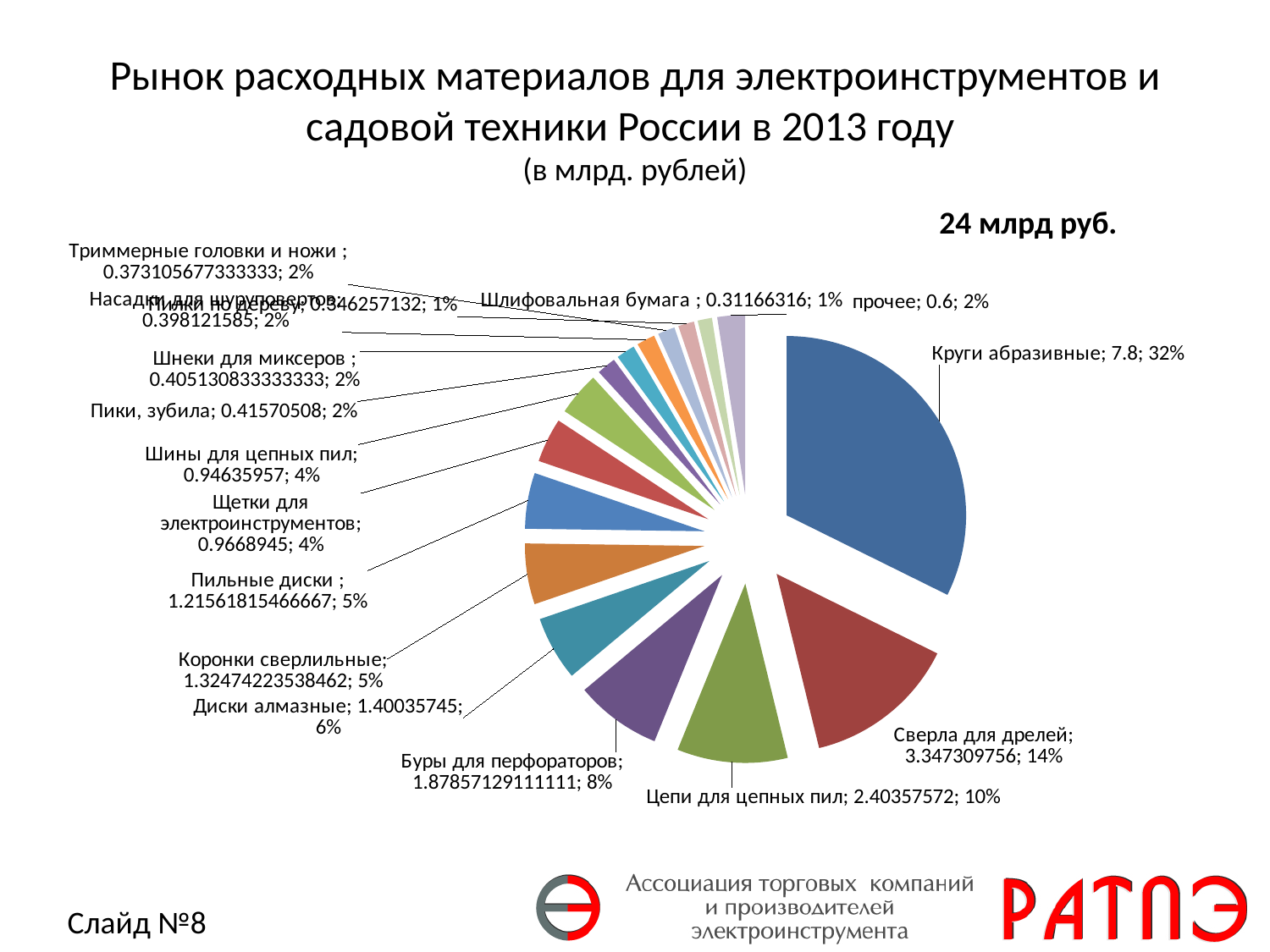
What is the difference between the values for Круги абразивные and Сверла для дрелей? 4.452690244 Which category has the largest share of the pie? Круги абразивные Which category has the smallest value in the pie? Шлифовальная бумага What share of the pie does Буры для перфораторов have? 8% What kind of chart is shown on the slide? pie chart What share of the pie does Круги абразивные have? 32% What total market size is stated on the slide next to the chart? 24 млрд руб. What is the value for Сверла для дрелей? 3.347309756 What is the value for прочее? 0.6 What is the value for Диски алмазные? 1.40035745 Which is larger, Щетки для электроинструментов or Шины для цепных пил? Щетки для электроинструментов What is the value for Цепи для цепных пил? 2.40357572